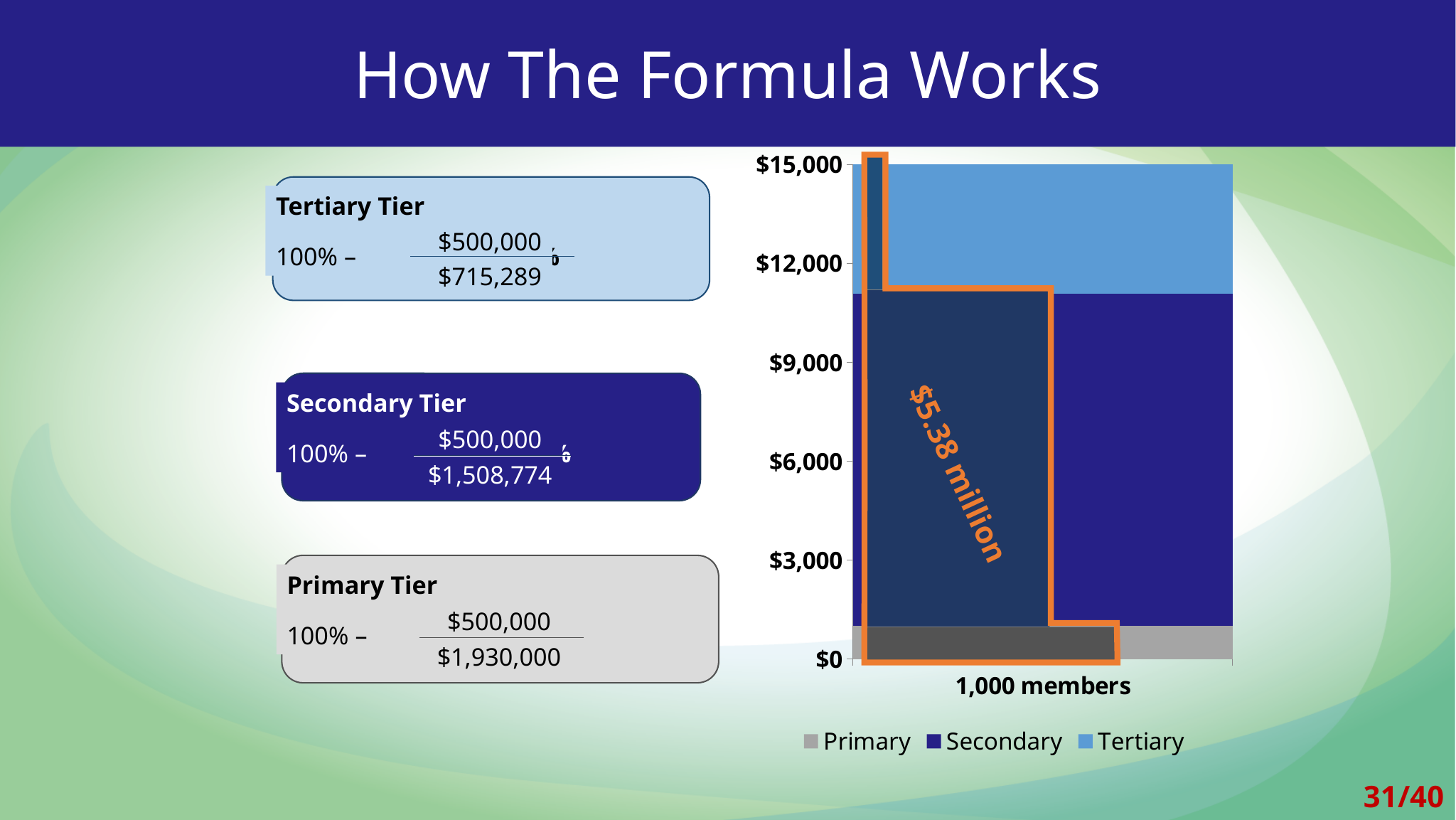
What kind of chart is shown on the slide? stacked bar chart Which segment is larger in the stacked bar, Primary or Tertiary? Tertiary Is the top of the Secondary segment greater or less than $9,000? greater Which segment is larger in the stacked bar, Secondary or Tertiary? Secondary How many categories are plotted on the x axis of the chart? 1 Is the value of the Primary segment greater or less than $3,000? less What amount is written in orange text across the highlighted portion of the bar? $5.38 million What is the category label on the x axis of the chart? 1,000 members Which series forms the largest segment of the stacked bar? Secondary Which series forms the smallest segment of the stacked bar? Primary Is the total height of the stacked bar greater or less than $12,000? greater How many series does the chart legend list? 3